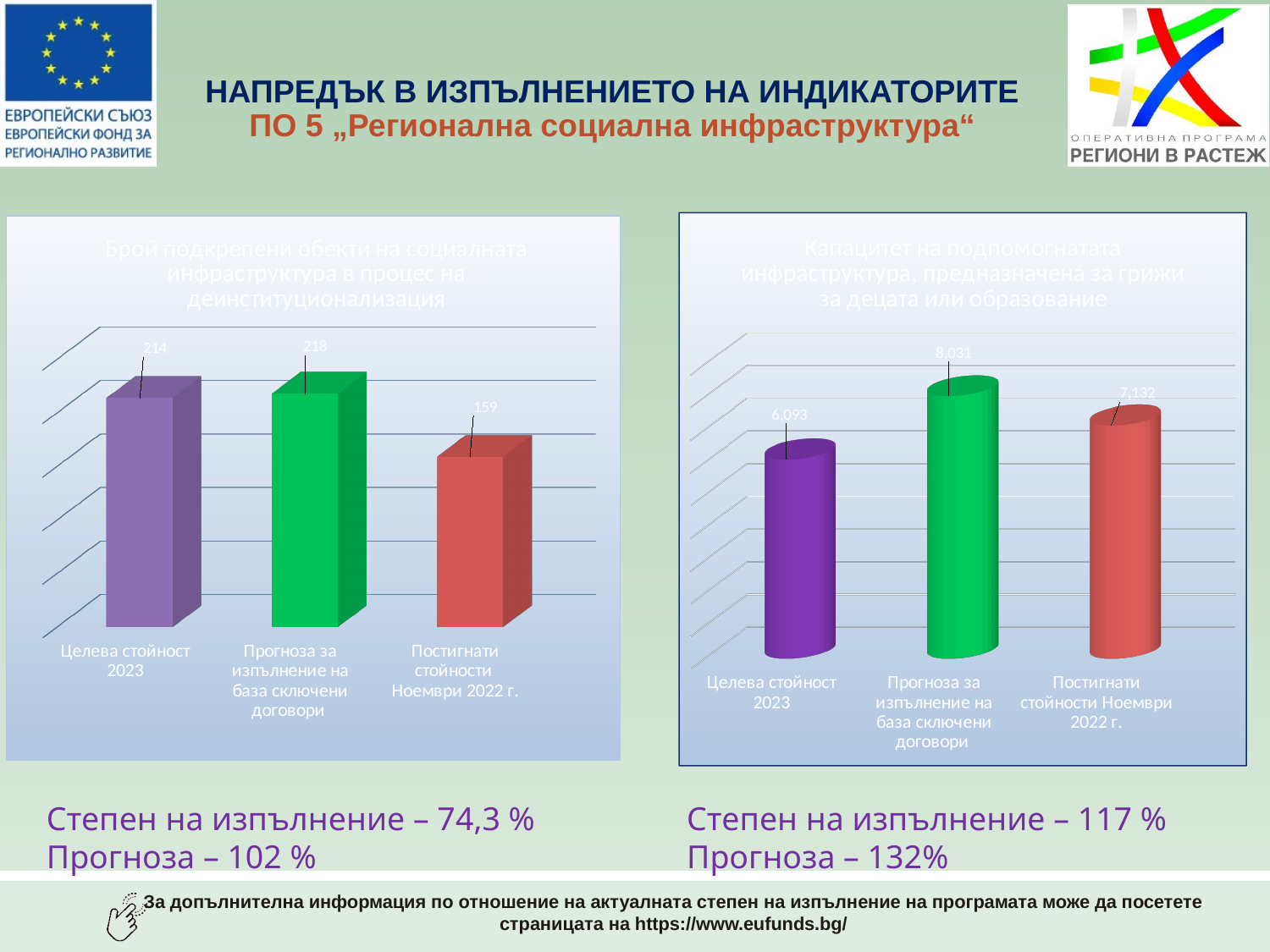
On the left chart, what is the difference between the value for Целева стойност 2023 and the value for Постигнати стойности Ноември 2022 г.? 55 On the left chart, what is the value for Постигнати стойности Ноември 2022 г.? 159 On the left chart, which category has the highest value? Прогноза за изпълнение на база сключени договори On the right chart, what is the value for Прогноза за изпълнение на база сключени договори? 8,031 On the right chart, what is the difference between the value for Постигнати стойности Ноември 2022 г. and the value for Целева стойност 2023? 1,039 On the right chart, what is the value for Целева стойност 2023? 6,093 What kind of chart is the right chart? Bar chart On the right chart, which is larger: the value for Прогноза за изпълнение на база сключени договори or the value for Постигнати стойности Ноември 2022 г.? Прогноза за изпълнение на база сключени договори On the right chart, which category has the lowest value? Целева стойност 2023 On the left chart, what is the value for Целева стойност 2023? 214 On the left chart, which category has the lowest value? Постигнати стойности Ноември 2022 г. How many categories are shown on the left chart? 3